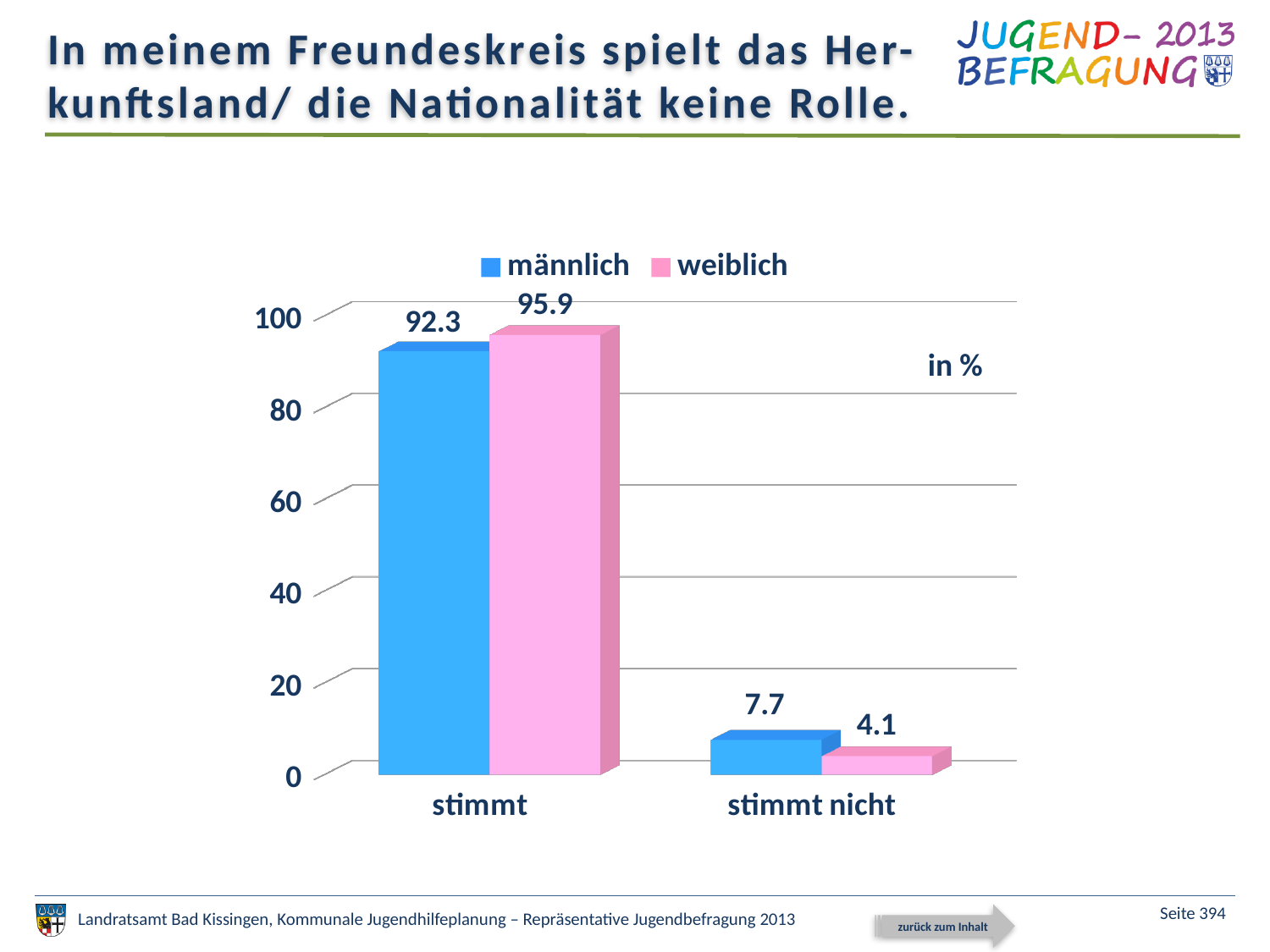
What is the difference between the männlich and weiblich values in the stimmt nicht category? 3.6 What is the value for weiblich in the stimmt category? 95.9 What colour represents the weiblich series? pink Which series has the higher value in the stimmt nicht category? männlich Which series has the higher value in the stimmt category? weiblich How many series does the legend list? 2 What is the difference between the weiblich and männlich values in the stimmt category? 3.6 What is the value for weiblich in the stimmt nicht category? 4.1 What kind of chart is shown on the slide? bar chart What is the value for männlich in the stimmt category? 92.3 How many categories are shown on the x axis? 2 What is the value for männlich in the stimmt nicht category? 7.7